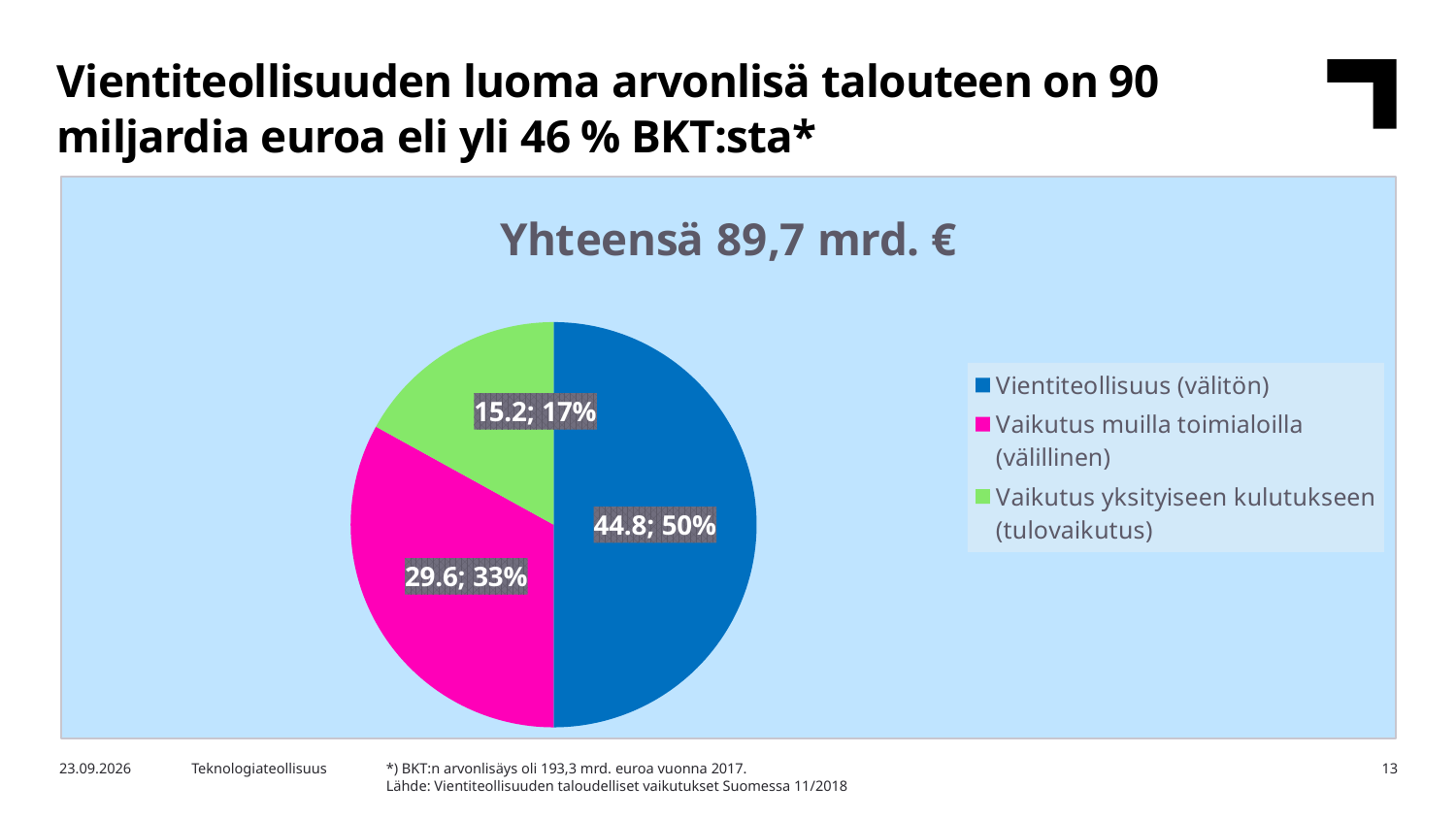
What value is shown for Vaikutus muilla toimialoilla (välillinen)? 29.6 What share of the pie does Vaikutus yksityiseen kulutukseen (tulovaikutus) represent? 17% Which slice is the smallest? Vaikutus yksityiseen kulutukseen (tulovaikutus) Which slice is the largest? Vientiteollisuus (välitön) What value is shown for Vaikutus yksityiseen kulutukseen (tulovaikutus)? 15.2 What is the title of the chart? Yhteensä 89,7 mrd. € What share of the pie does Vientiteollisuus (välitön) represent? 50% How many entries does the legend list? 3 What kind of chart is shown on the slide? Pie chart How many slices does the pie chart have? 3 What is the difference between the values for Vientiteollisuus (välitön) and Vaikutus muilla toimialoilla (välillinen)? 15.2 What value is shown for Vientiteollisuus (välitön)? 44.8